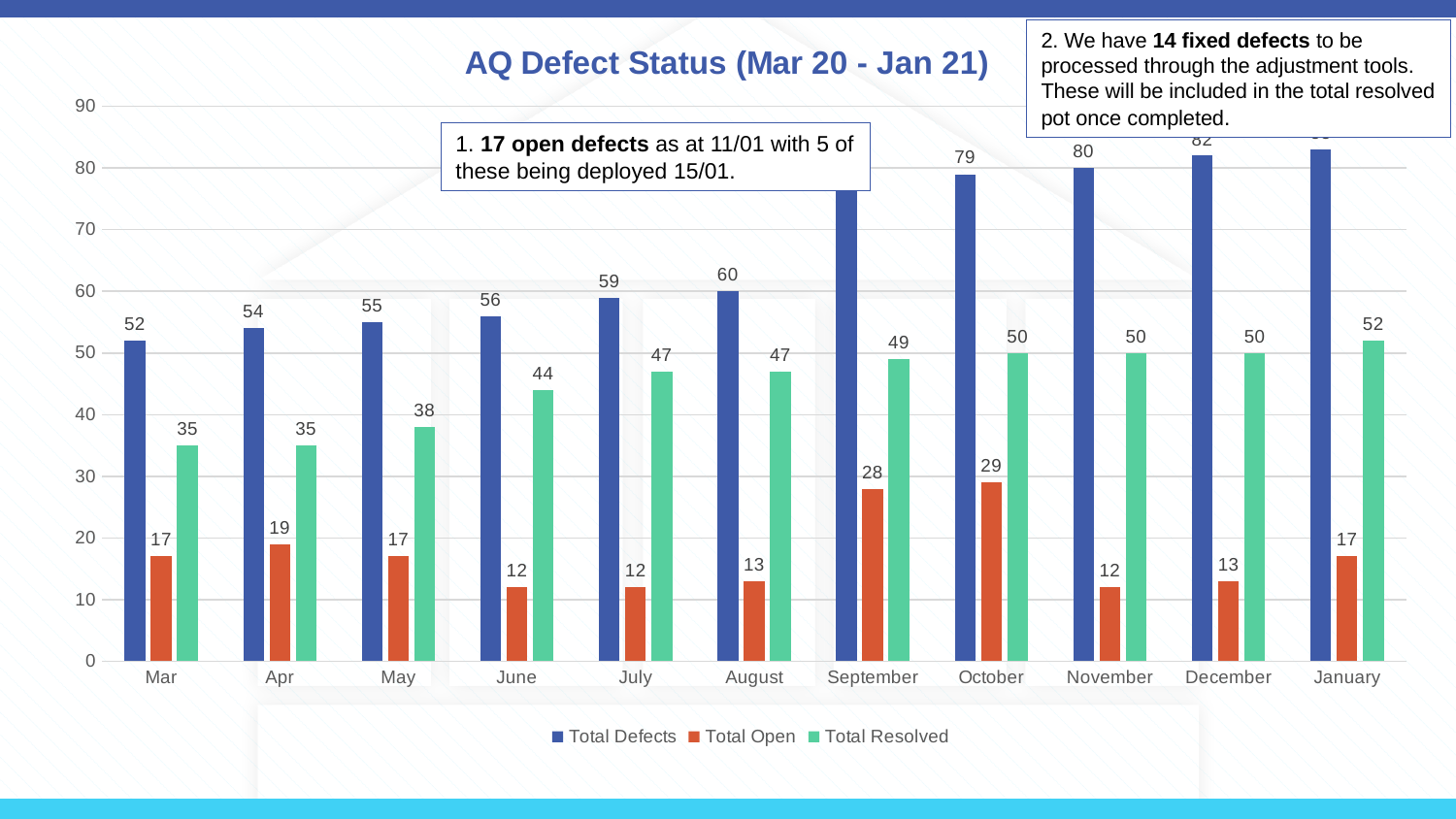
Which month has the highest Total Resolved value? January What colour represents Total Resolved in the legend? green How many series does the legend list? 3 How many months are shown on the x axis? 11 Is the value of Total Defects for September greater or less than 70? greater What kind of chart is shown on the slide? bar chart What is the value of Total Resolved for January? 52 What is the value of Total Defects for Mar? 52 Do the Total Defects values rise or fall from Mar to November? rise What is the difference between Total Defects and Total Resolved for August? 13 What is the value of Total Open for October? 29 Which month has the larger Total Open value, Apr or May? Apr